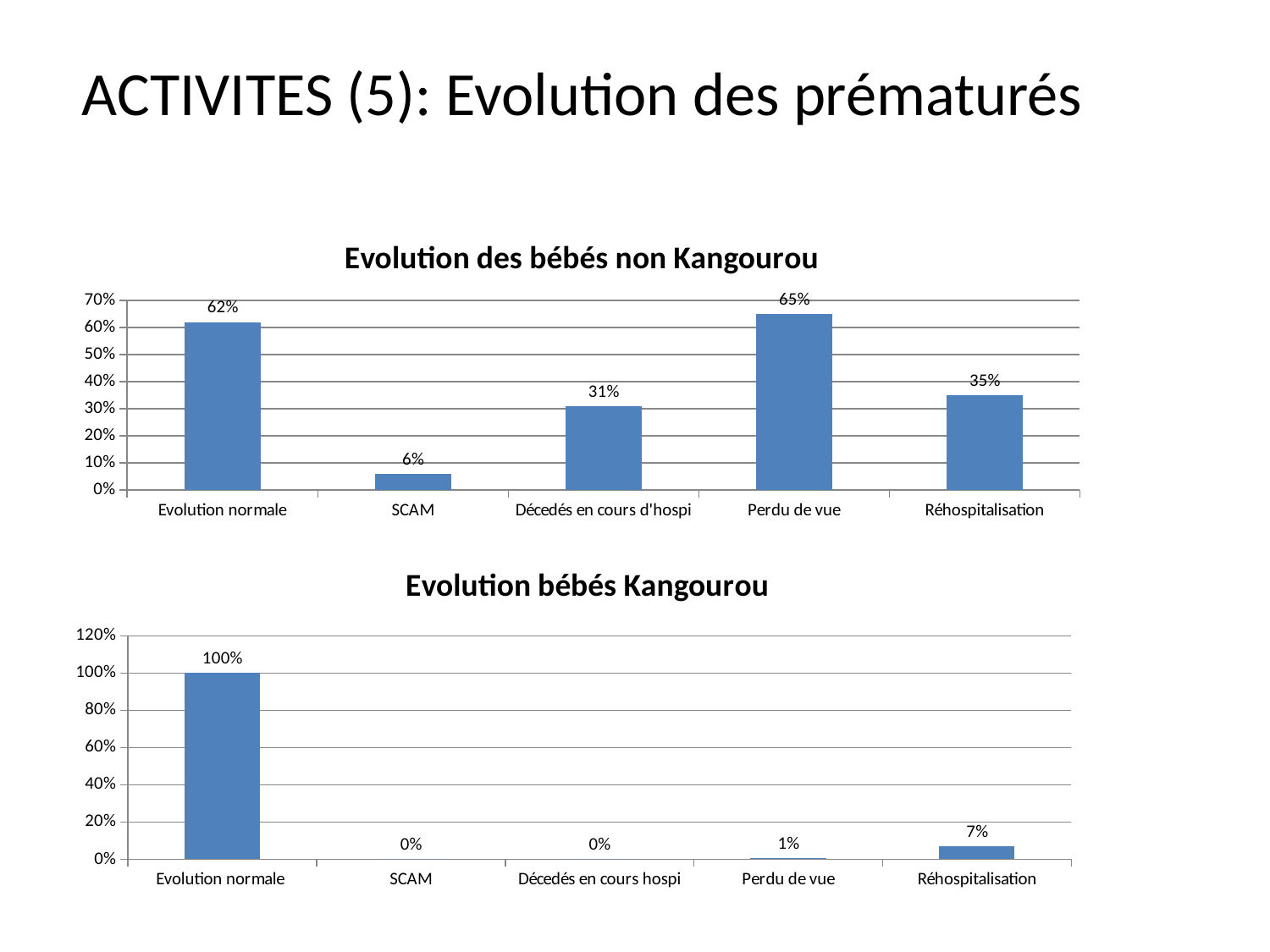
In the 'Evolution bébés Kangourou' chart, what is the value for Réhospitalisation? 7% In the 'Evolution des bébés non Kangourou' chart, what is the value for SCAM? 6% In the 'Evolution bébés Kangourou' chart, what is the value for Evolution normale? 100% In the 'Evolution bébés Kangourou' chart, which category has the highest value? Evolution normale What type of chart is 'Evolution des bébés non Kangourou'? Bar chart How many categories are shown in the 'Evolution bébés Kangourou' chart? 5 In the 'Evolution des bébés non Kangourou' chart, what is the value for Perdu de vue? 65% In the 'Evolution des bébés non Kangourou' chart, which is larger: Décedés en cours d'hospi or Réhospitalisation? Réhospitalisation In the 'Evolution des bébés non Kangourou' chart, which category has the lowest value? SCAM In the 'Evolution des bébés non Kangourou' chart, which category has the highest value? Perdu de vue In the 'Evolution des bébés non Kangourou' chart, what is the difference between Evolution normale and Réhospitalisation? 27% In the 'Evolution bébés Kangourou' chart, what is the value for Perdu de vue? 1%